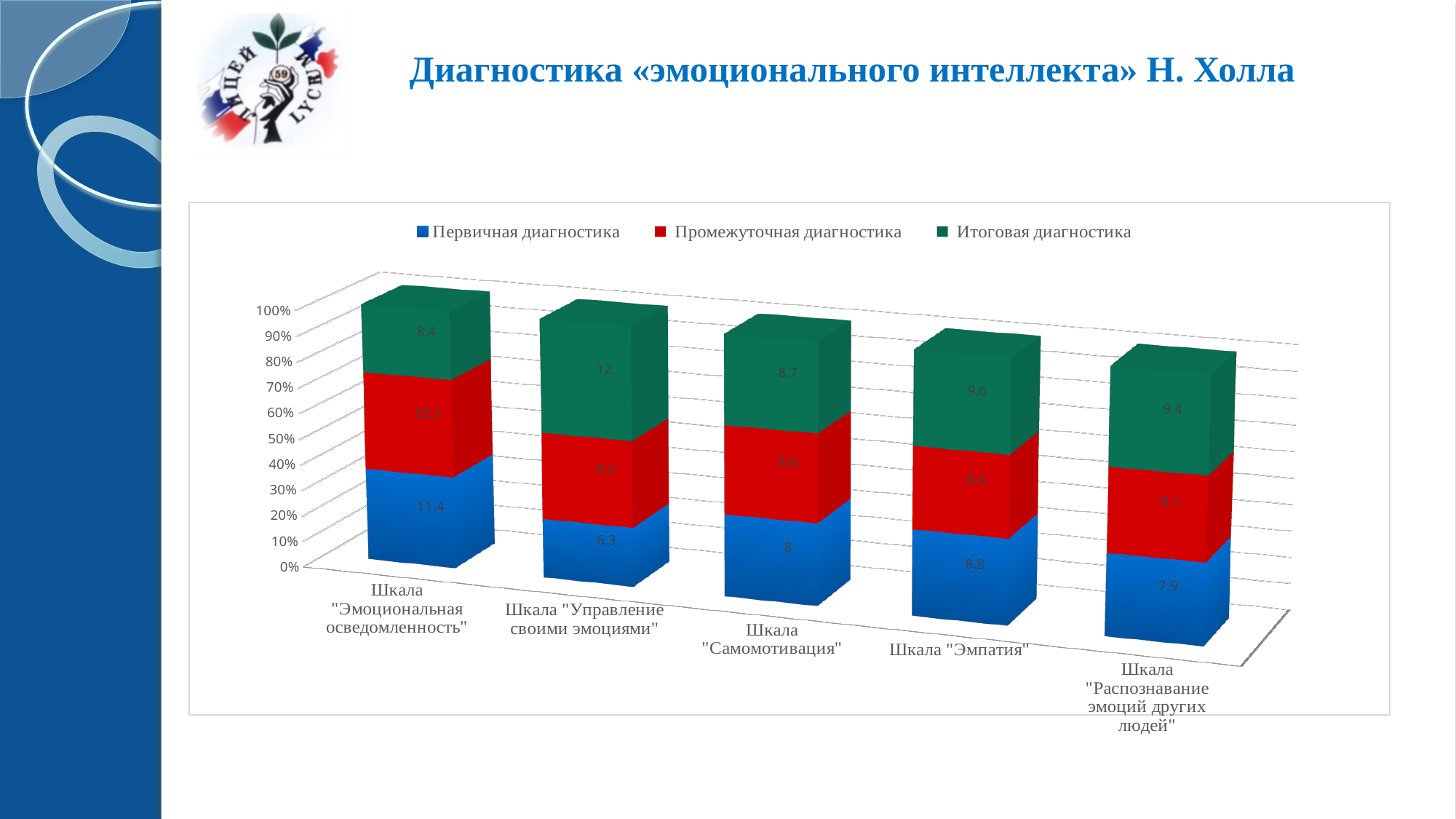
What kind of chart is shown on the slide? Stacked bar chart What is the value of Промежуточная диагностика for Шкала "Самомотивация"? 8.6 How many series does the legend list? 3 What is the value of Первичная диагностика for Шкала "Эмоциональная осведомленность"? 11.4 How many categories are shown on the x axis? 5 What is the sum of the three labelled values for Шкала "Самомотивация"? 25.3 What is the value of Итоговая диагностика for Шкала "Распознавание эмоций других людей"? 9.4 For Шкала "Управление своими эмоциями", how much larger is Итоговая диагностика than Первичная диагностика? 5.7 Which category has the lowest value for Первичная диагностика? Шкала "Управление своими эмоциями" Which has the larger Итоговая диагностика value: Шкала "Эмпатия" or Шкала "Распознавание эмоций других людей"? Шкала "Эмпатия" Which category has the highest value for Первичная диагностика? Шкала "Эмоциональная осведомленность" What is the value of Итоговая диагностика for Шкала "Управление своими эмоциями"? 12